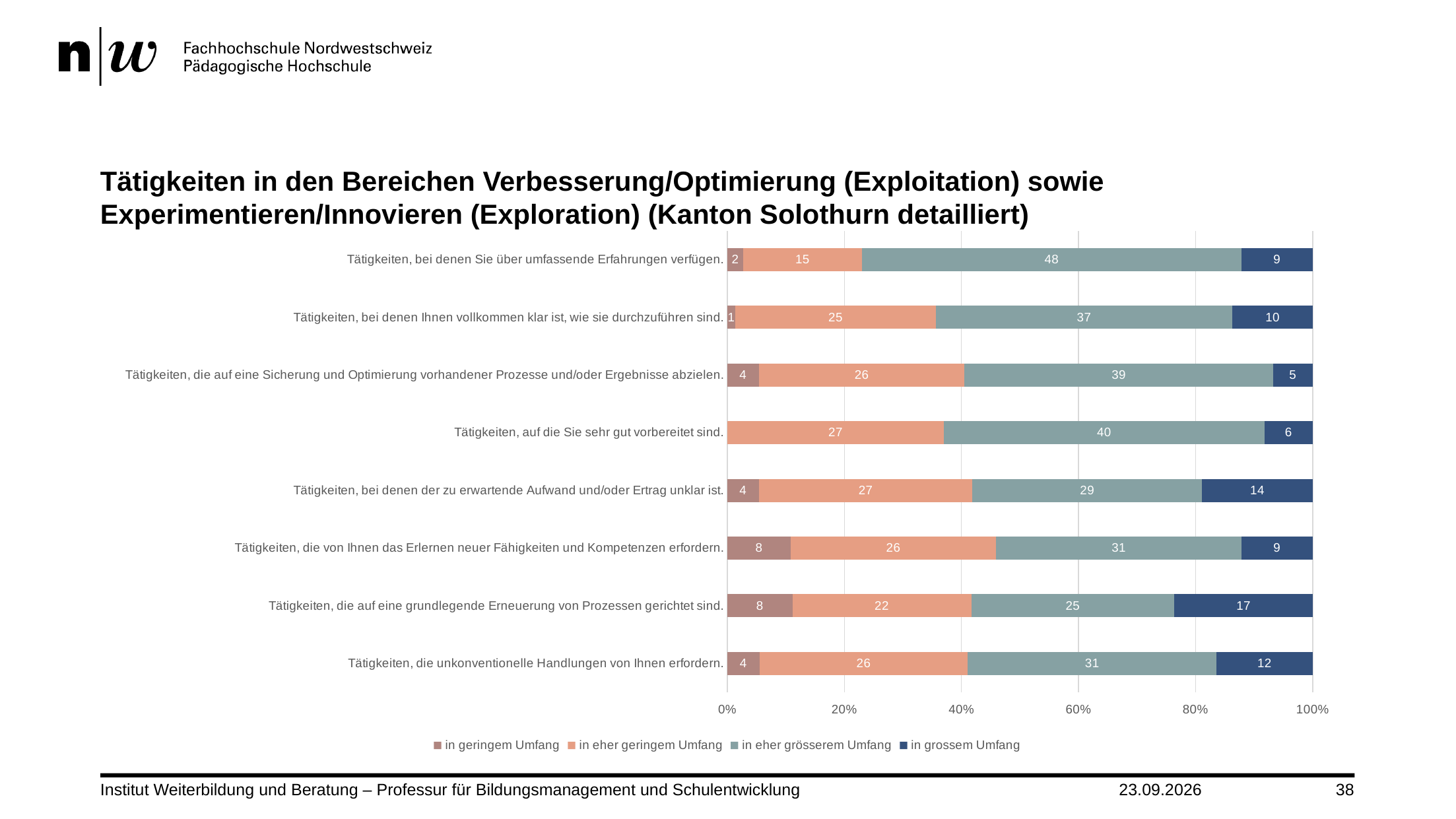
How many categories (activity types) are plotted in the chart? 8 What is the difference between the 'in eher grösserem Umfang' values for 'Tätigkeiten, bei denen Sie über umfassende Erfahrungen verfügen.' and 'Tätigkeiten, die auf eine grundlegende Erneuerung von Prozessen gerichtet sind.'? 23 What is the value for 'in eher grösserem Umfang' for 'Tätigkeiten, bei denen Sie über umfassende Erfahrungen verfügen.'? 48 Which is larger: the 'in geringem Umfang' value for 'Tätigkeiten, die von Ihnen das Erlernen neuer Fähigkeiten und Kompetenzen erfordern.' or for 'Tätigkeiten, die unkonventionelle Handlungen von Ihnen erfordern.'? Tätigkeiten, die von Ihnen das Erlernen neuer Fähigkeiten und Kompetenzen erfordern. How many series does the legend list? 4 What is the value for 'in eher geringem Umfang' for 'Tätigkeiten, auf die Sie sehr gut vorbereitet sind.'? 27 Which category has the highest value for 'in grossem Umfang'? Tätigkeiten, die auf eine grundlegende Erneuerung von Prozessen gerichtet sind. What is the total of all segments in the bar for 'Tätigkeiten, bei denen der zu erwartende Aufwand und/oder Ertrag unklar ist.'? 74 Which category has the lowest value for 'in grossem Umfang'? Tätigkeiten, die auf eine Sicherung und Optimierung vorhandener Prozesse und/oder Ergebnisse abzielen. Which legend entry is shown in dark blue? in grossem Umfang What kind of chart is shown on the slide? stacked bar chart What is the value for 'in grossem Umfang' for 'Tätigkeiten, die auf eine grundlegende Erneuerung von Prozessen gerichtet sind.'? 17